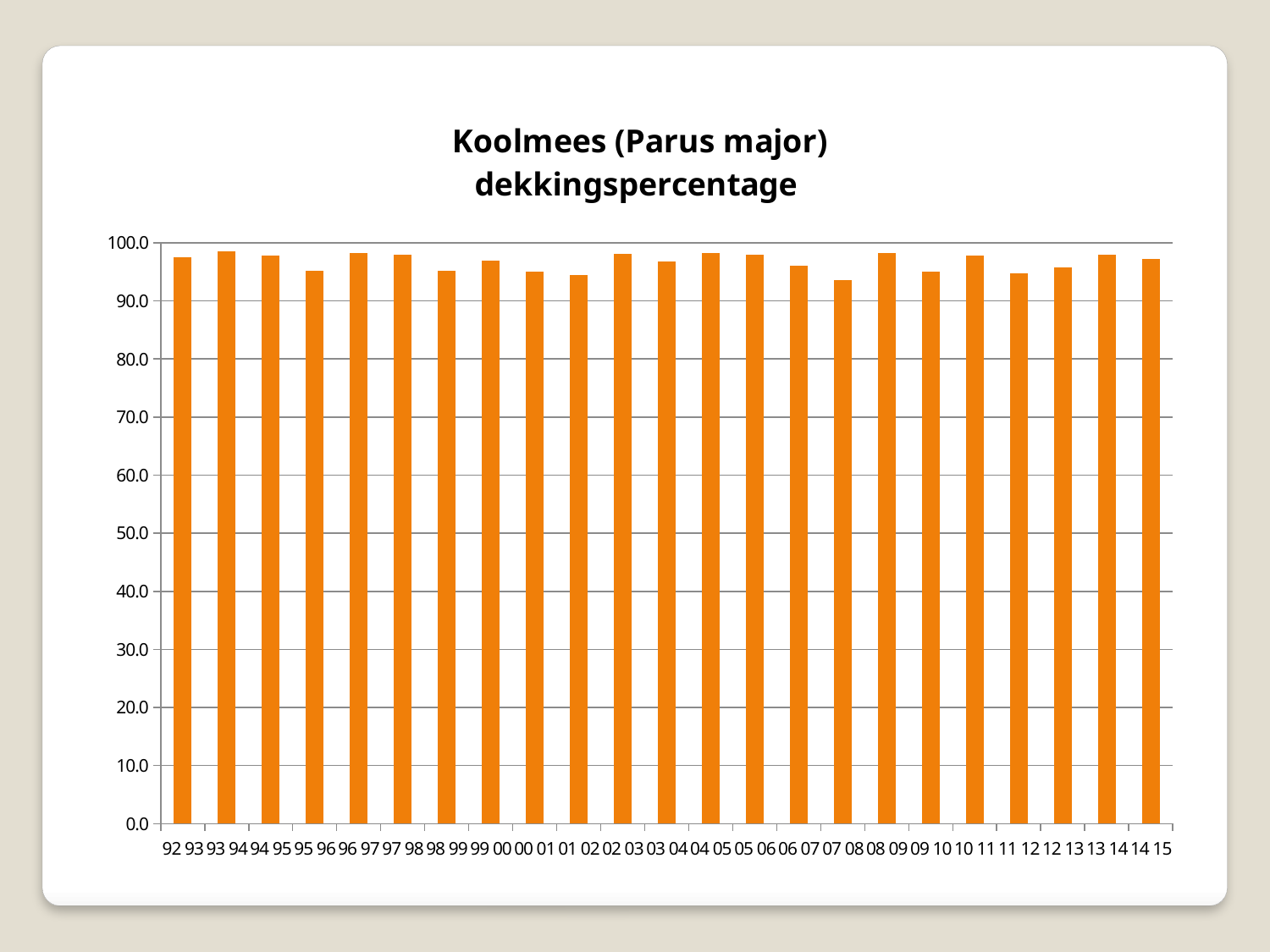
Is the value for 07 08 greater or less than 90.0? greater What is the title of the chart? Koolmees (Parus major) dekkingspercentage Which is larger, the value for 92 93 or the value for 07 08? 92 93 Which is larger, the value for 08 09 or the value for 11 12? 08 09 What colour are the bars in the chart? orange What is the highest value shown on the y axis? 100.0 What kind of chart is shown on the slide? bar chart Is the value for 92 93 greater or less than 100.0? less Is the value for 01 02 greater or less than 80.0? greater How many bars (seasons) are plotted in the chart? 23 Which is larger, the value for 96 97 or the value for 01 02? 96 97